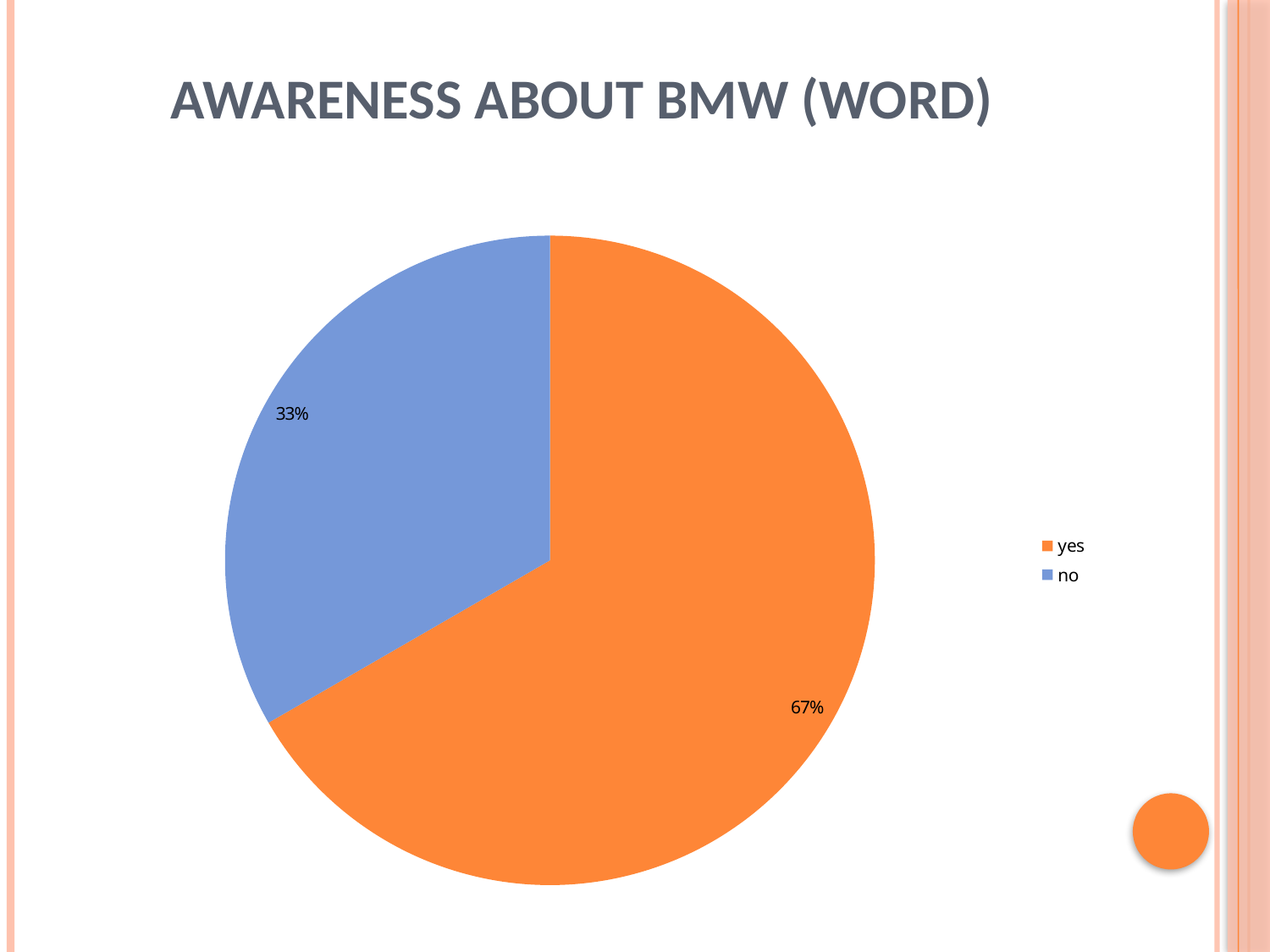
What is the difference in percentage points between the "yes" and "no" slices? 34 percentage points Which category has the smallest slice of the pie? no What type of chart is shown on the slide? pie chart How many entries does the legend list? 2 What share of the pie does the "yes" slice represent? 67% What share of the pie does the "no" slice represent? 33% How many slices does the pie chart have? 2 What is the title of the slide containing the chart? AWARENESS ABOUT BMW (WORD) What colour is the "no" slice in the pie chart? blue Which category has the largest slice of the pie? yes Which is larger, the "yes" slice or the "no" slice? yes